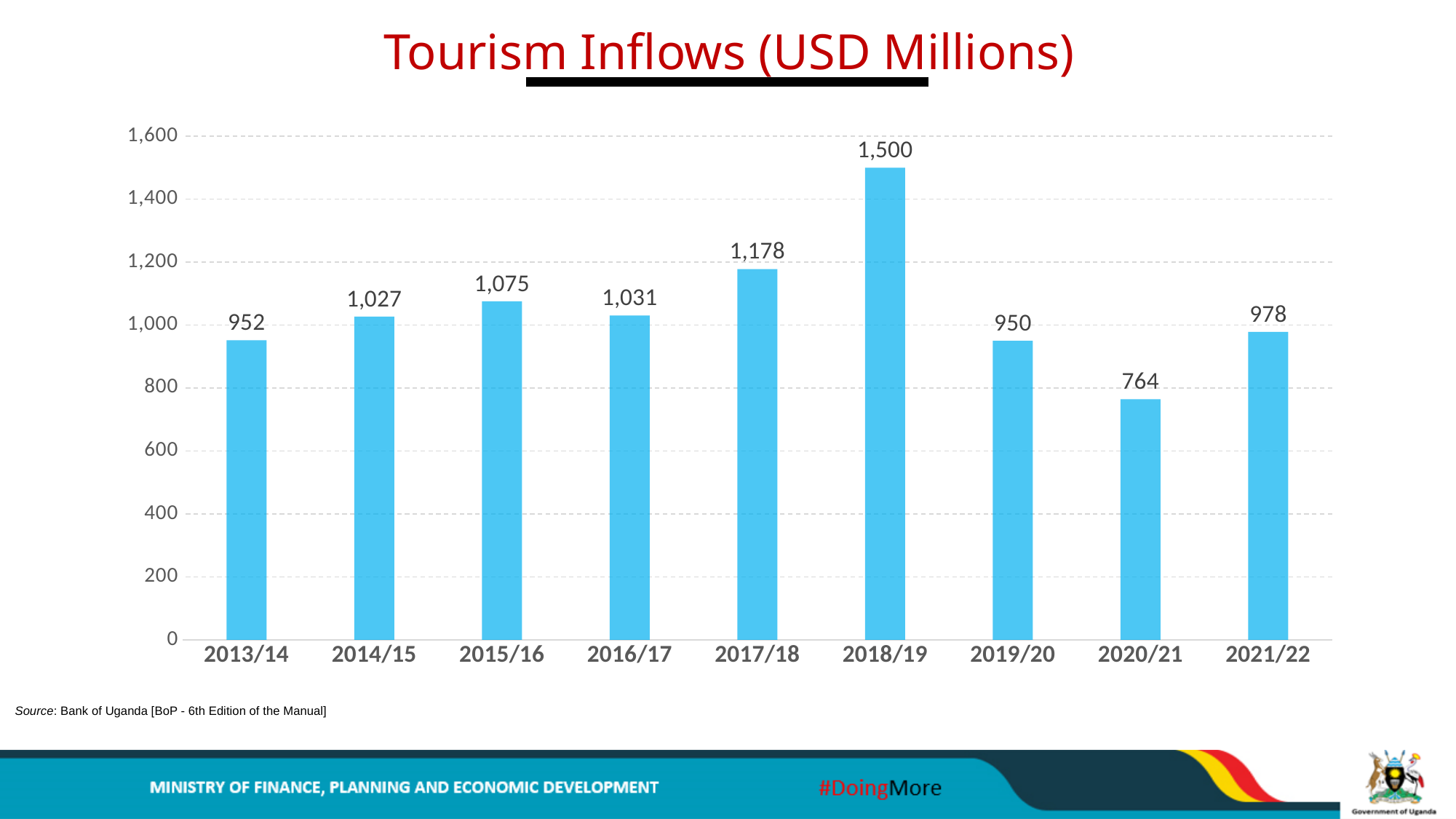
What is the tourism inflow value for 2015/16? 1,075 What is the title of the chart? Tourism Inflows (USD Millions) Which year has the lowest tourism inflows? 2020/21 What kind of chart is shown on the slide? Bar chart What is the difference between the tourism inflows in 2021/22 and 2020/21? 214 What is the difference between the tourism inflows in 2018/19 and 2019/20? 550 Is the value for 2013/14 greater or less than 1,000? less Which year has larger tourism inflows, 2017/18 or 2016/17? 2017/18 What is the tourism inflow value for 2018/19? 1,500 How many years are shown on the x axis? 9 Which year has the highest tourism inflows? 2018/19 What is the tourism inflow value for 2020/21? 764